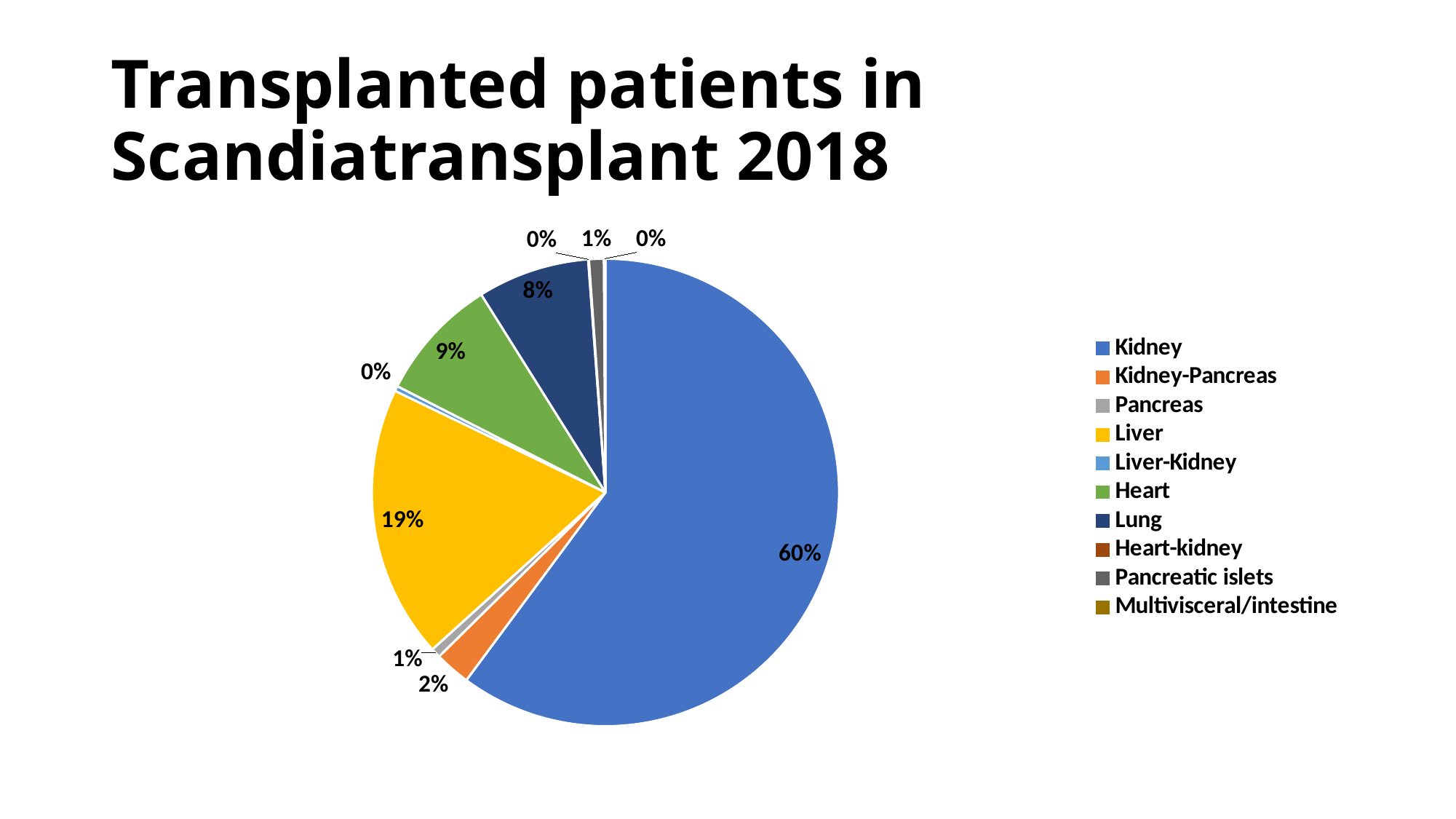
What percentage is shown for the Lung slice? 8% What is the title of the slide? Transplanted patients in Scandiatransplant 2018 What percentage is shown for the Liver slice? 19% What is the difference in percentage points between the Heart share and the Lung share? 1 Which category has the largest share of the pie? Kidney What is the difference in percentage points between the Kidney share and the Liver share? 41 What percentage is shown for the Kidney-Pancreas slice? 2% What share of transplanted patients does the Kidney slice represent? 60% How many categories does the legend list? 10 Which is larger, the Liver share or the Heart share? Liver What percentage is shown for the Heart slice? 9% What kind of chart is shown on the slide? pie chart